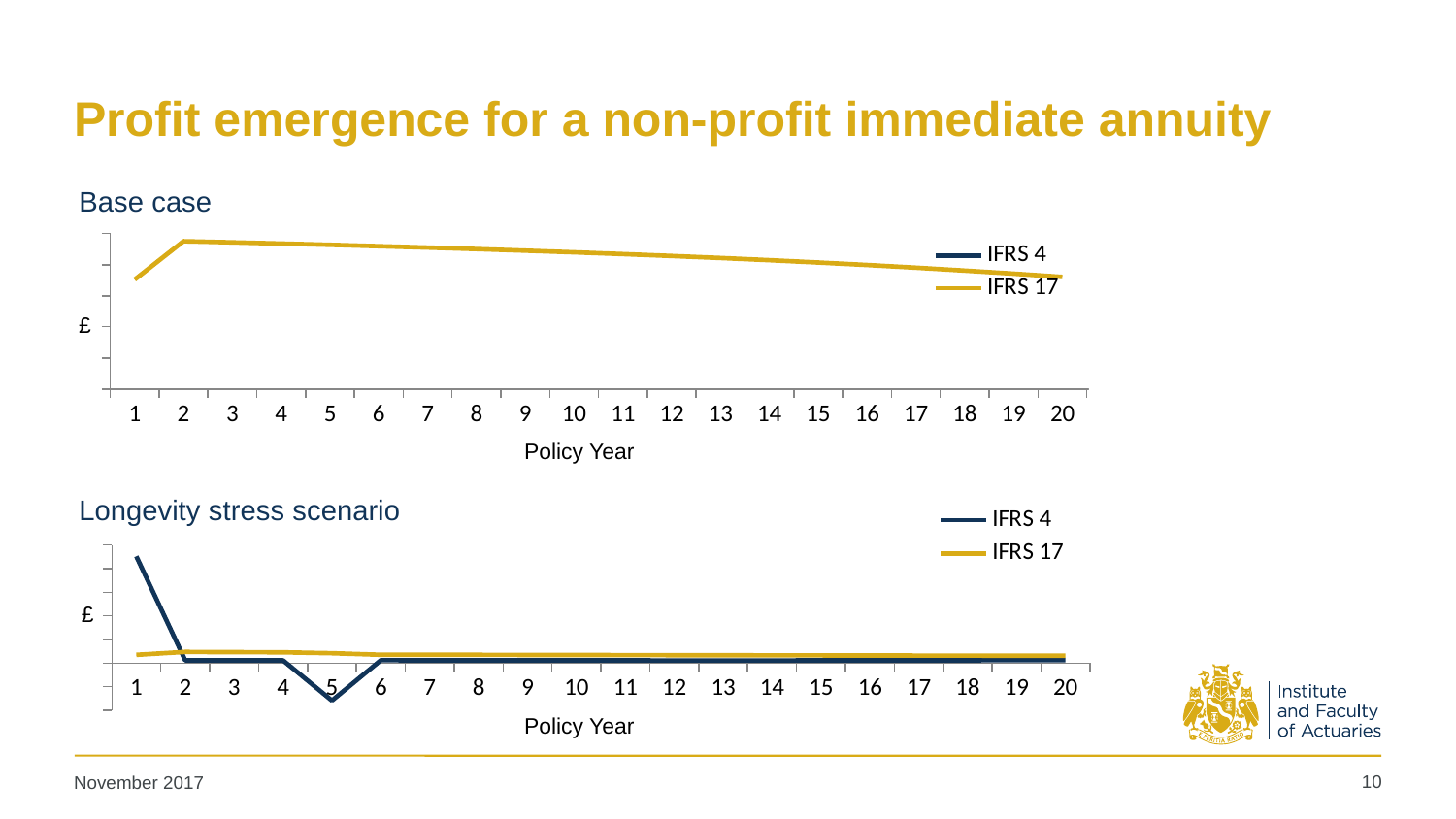
In the Longevity stress scenario chart, in which policy year is the IFRS 4 value lowest? 5 In the Longevity stress scenario chart, which series has the larger value in policy year 1, IFRS 4 or IFRS 17? IFRS 4 What type of chart is the Base case chart? line chart In the Base case chart, does the IFRS 17 line rise or fall from policy year 2 to policy year 20? fall How many policy years are shown on the x axis of the Base case chart? 20 In the Base case chart, does the IFRS 17 line rise or fall from policy year 1 to policy year 2? rise In the Longevity stress scenario chart, in which policy year is the IFRS 4 value highest? 1 What is the x-axis label of the Longevity stress scenario chart? Policy Year How many series does the legend of the Longevity stress scenario chart list? 2 What are the two series named in the legend of the Base case chart? IFRS 4 and IFRS 17